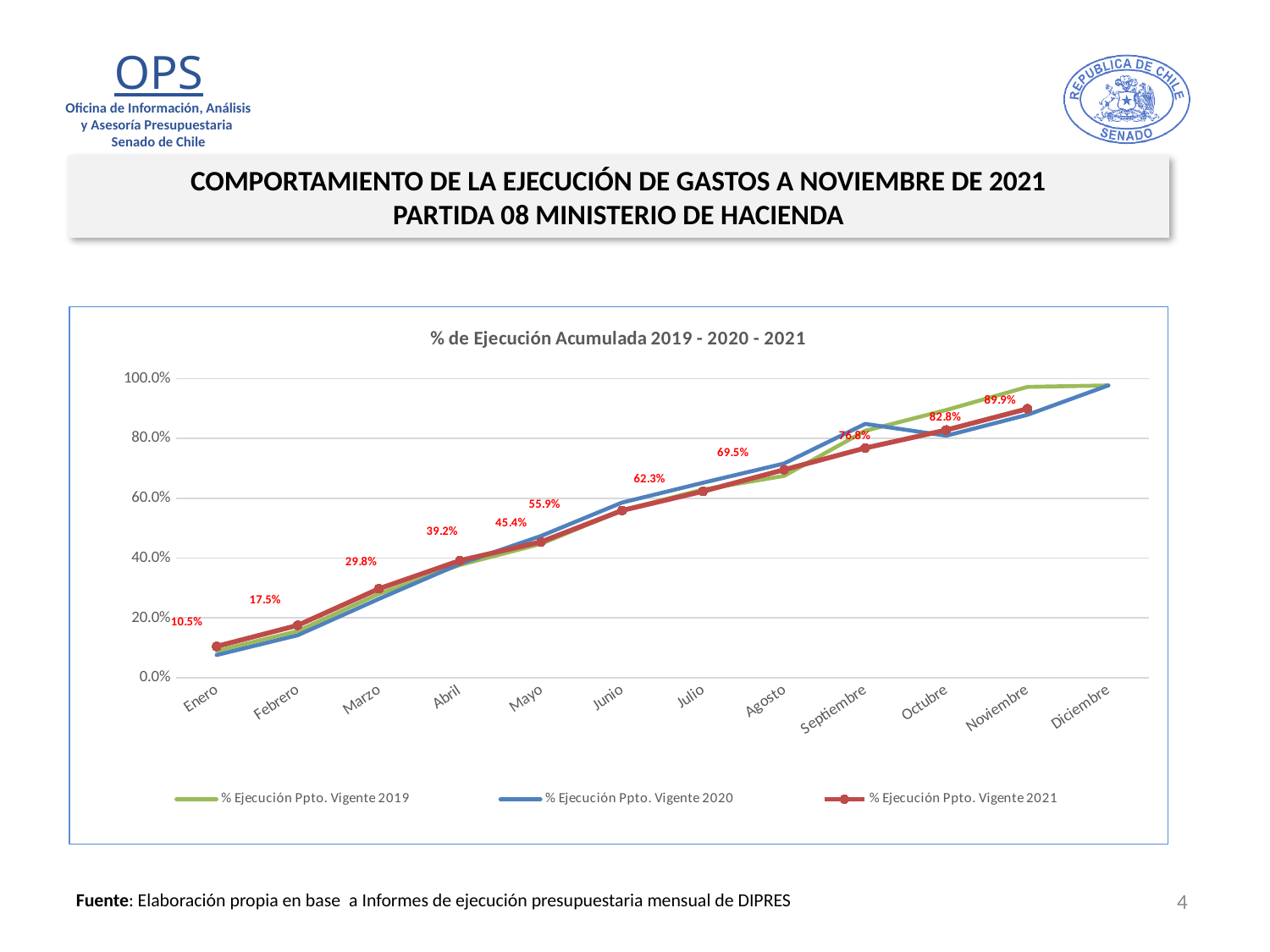
What type of chart is shown on the slide? line chart How many series does the legend list? 3 How many months are shown on the x axis? 12 What is the value for % Ejecución Ppto. Vigente 2021 in Enero? 10.5% What is the title of the chart? % de Ejecución Acumulada 2019 - 2020 - 2021 Does the % Ejecución Ppto. Vigente 2021 series rise or fall from Enero to Noviembre? rise What is the difference between the 2021 values for Noviembre and Octubre? 7.1% What is the difference between the 2021 values for Marzo and Febrero? 12.3% What is the value for % Ejecución Ppto. Vigente 2021 in Noviembre? 89.9% Which month has the highest value for % Ejecución Ppto. Vigente 2021? Noviembre What is the value for % Ejecución Ppto. Vigente 2021 in Junio? 55.9% Is the value for % Ejecución Ppto. Vigente 2020 in Diciembre greater or less than 80.0%? greater